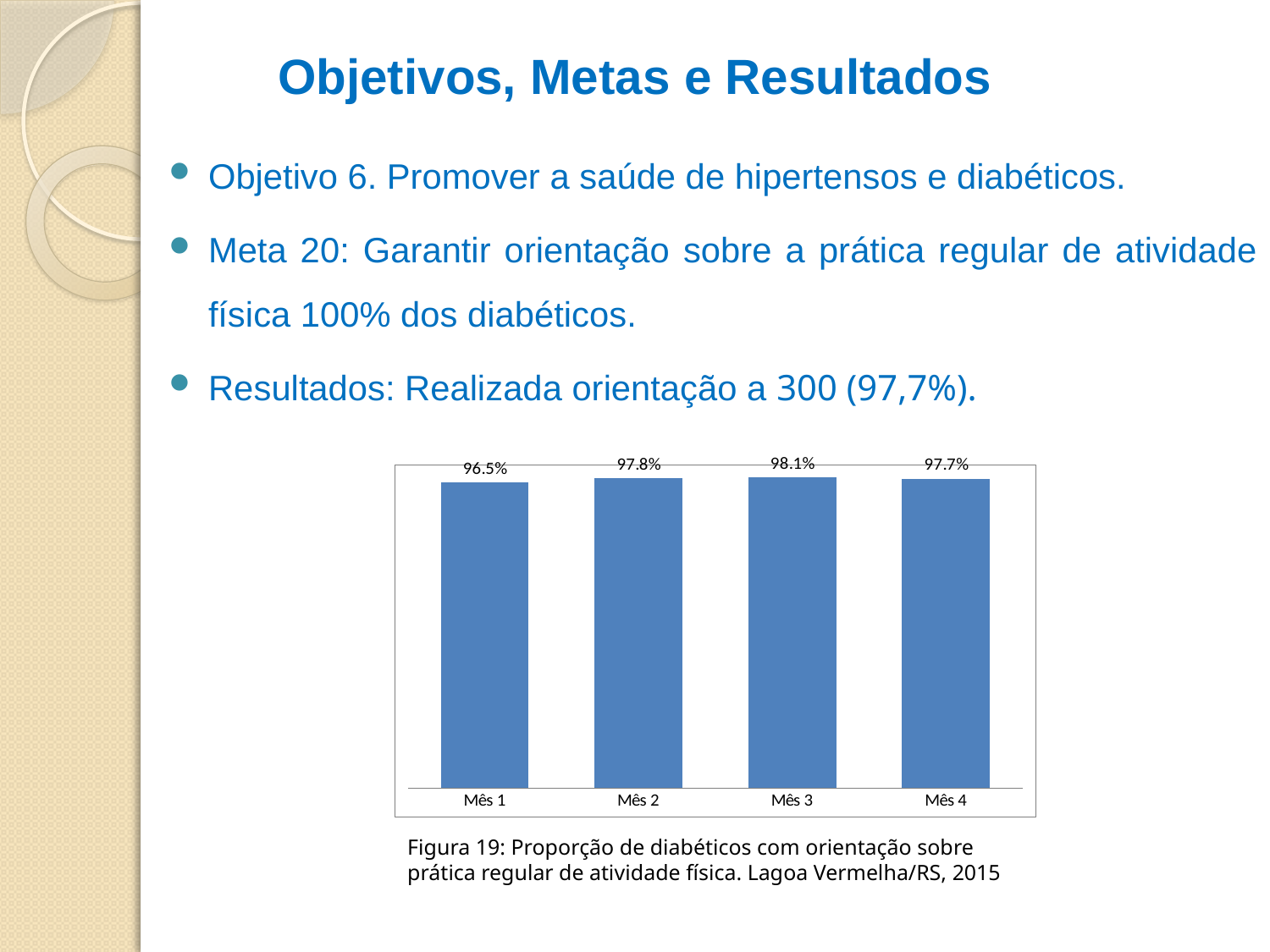
What is the value for Mês 2? 97.8% Which month has the highest value? Mês 3 How many months are shown on the x axis? 4 What is the difference between the values for Mês 3 and Mês 1? 1.6 percentage points What kind of chart is shown on the slide? Bar chart What is the value for Mês 1? 96.5% Which is larger, the value for Mês 1 or the value for Mês 3? Mês 3 What figure number is given in the caption below the chart? Figura 19 Which month has the lowest value? Mês 1 What is the value for Mês 3? 98.1% What is the value for Mês 4? 97.7% Does the value rise or fall from Mês 1 to Mês 2? Rise